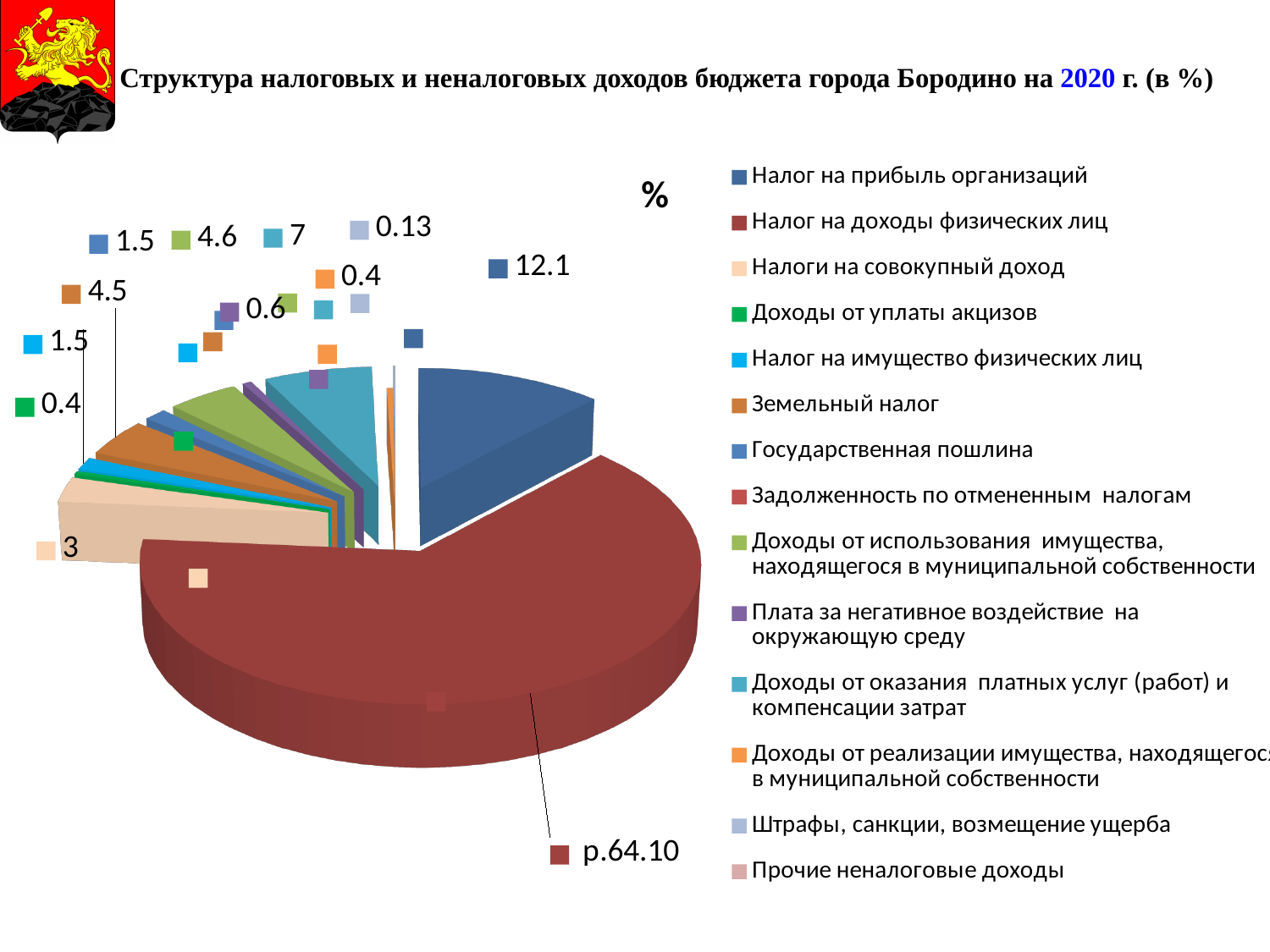
What is the value shown for Земельный налог? 4.5 What is the value shown for Налог на прибыль организаций? 12.1 What is the value shown for Штрафы, санкции, возмещение ущерба? 0.13 What kind of chart is shown on the slide? Pie chart What year does the chart title refer to? 2020 Which is larger: the value for Земельный налог or the value for Доходы от использования имущества, находящегося в муниципальной собственности? Доходы от использования имущества, находящегося в муниципальной собственности What is the difference between the values for Налог на прибыль организаций and Доходы от оказания платных услуг (работ) и компенсации затрат? 5.1 Which category has the largest share of the pie? Налог на доходы физических лиц What is the value shown for Налоги на совокупный доход? 3 What is the value shown for Налог на доходы физических лиц? р.64.10 How many entries does the legend list? 14 What is the value shown for Доходы от оказания платных услуг (работ) и компенсации затрат? 7